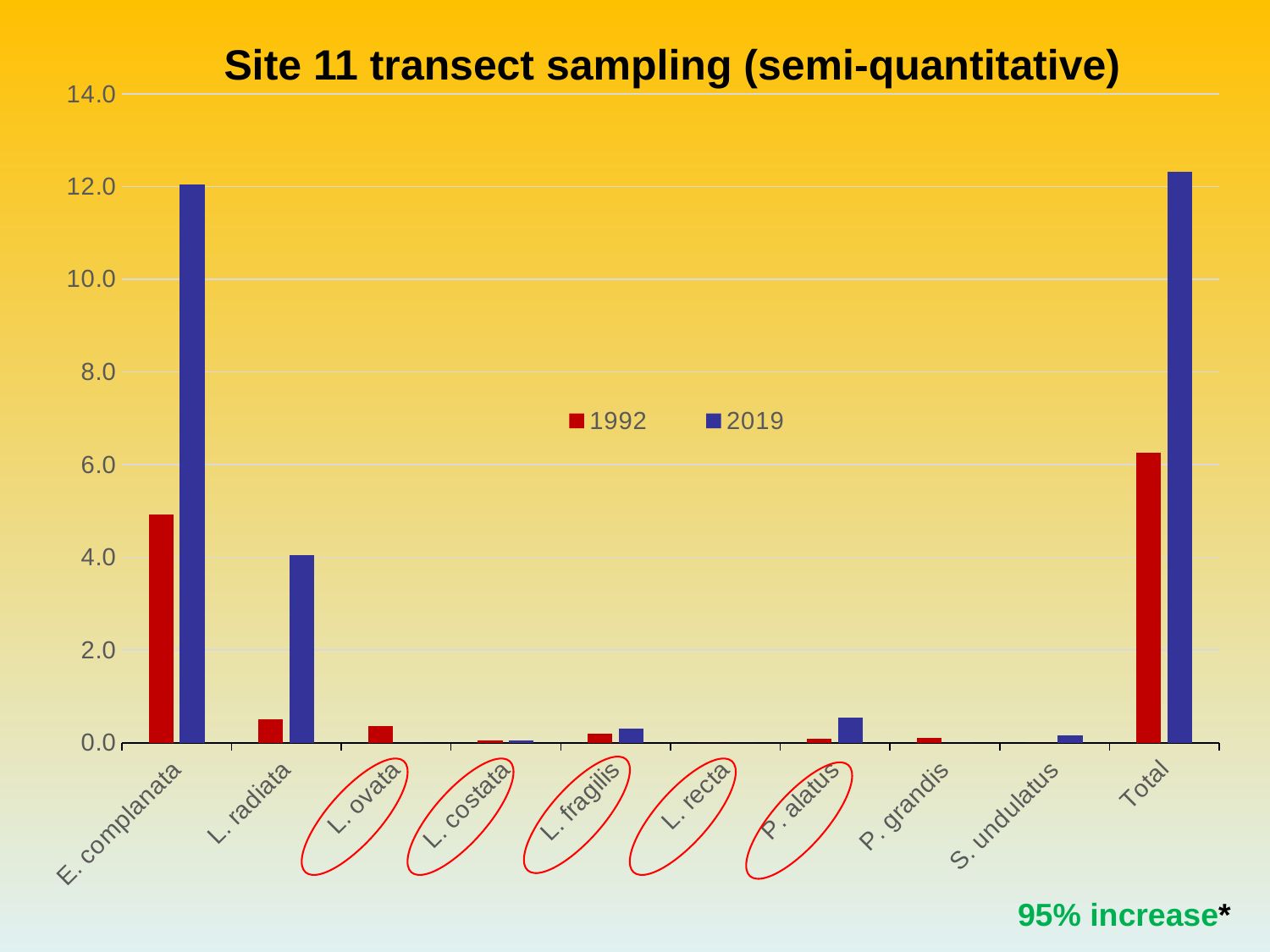
For E. complanata, which year has the larger value, 1992 or 2019? 2019 Is the 2019 value for E. complanata greater or less than 10.0? greater Is the 2019 value for L. radiata greater or less than 2.0? greater Is the 1992 value for Total greater or less than 8.0? less Among the individual species (excluding Total), which has the highest 2019 value? E. complanata How many categories are shown along the x axis? 10 Which category has the tallest 2019 bar? Total How many series does the legend list? 2 What is the title of the chart? Site 11 transect sampling (semi-quantitative) What kind of chart is shown on the slide? bar chart For L. ovata, which year has the larger value, 1992 or 2019? 1992